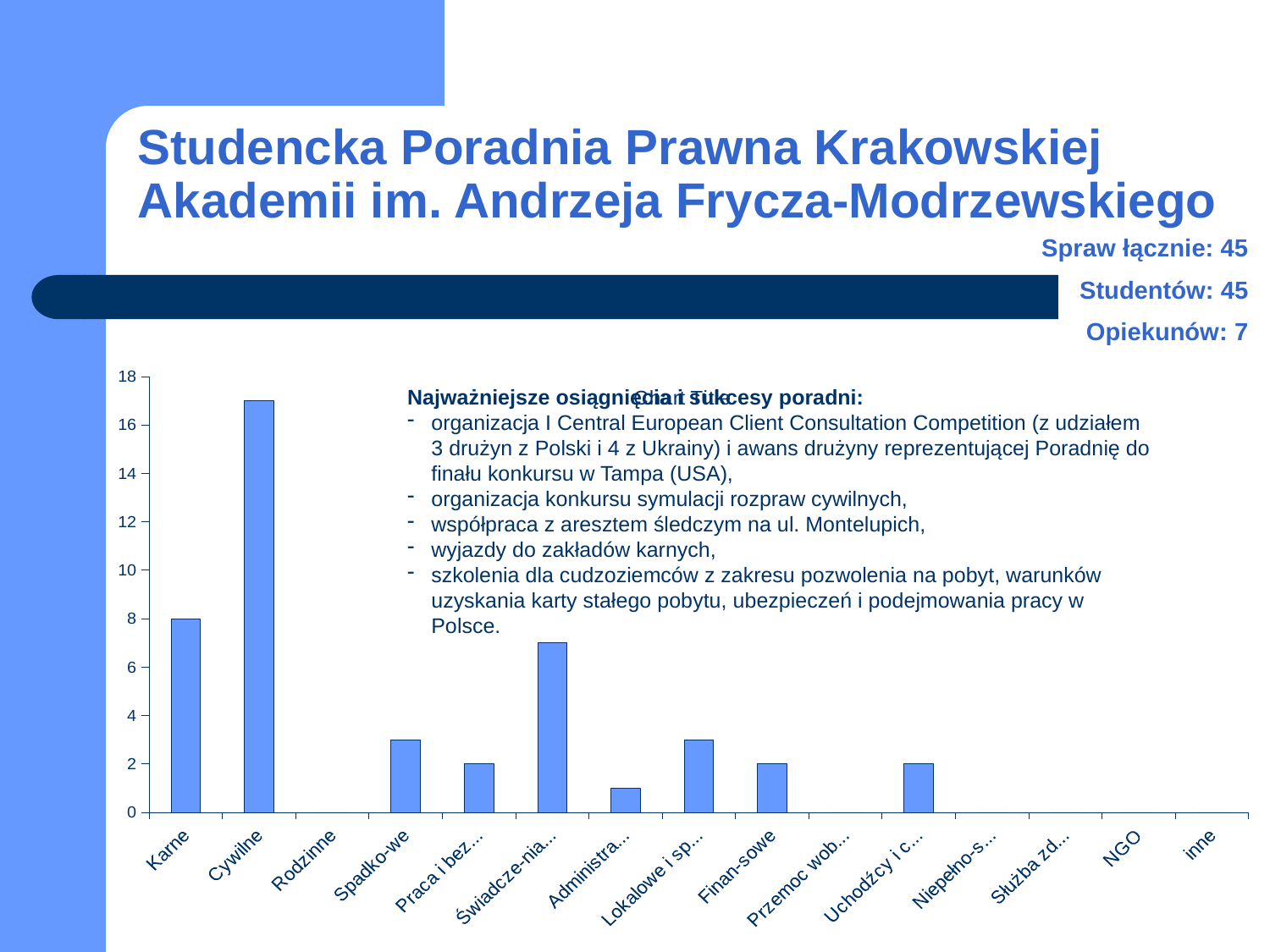
Is the value for Cywilne greater or less than 16? greater What is the value for Praca i bez... in the chart? 2 Is the value for Świadcze-nia... greater or less than 6? greater Which category has the highest bar in the chart? Cywilne Is the value for Administra... greater or less than 2? less What type of chart is shown on the slide? bar chart Which is larger, the value for Karne or the value for Spadko-we? Karne Which is larger, the value for Cywilne or the value for Karne? Cywilne What is the value for Karne in the chart? 8 How many categories are shown on the x axis of the chart? 15 What is the difference between the value for Karne and the value for Finan-sowe? 6 What is the value for Finan-sowe in the chart? 2